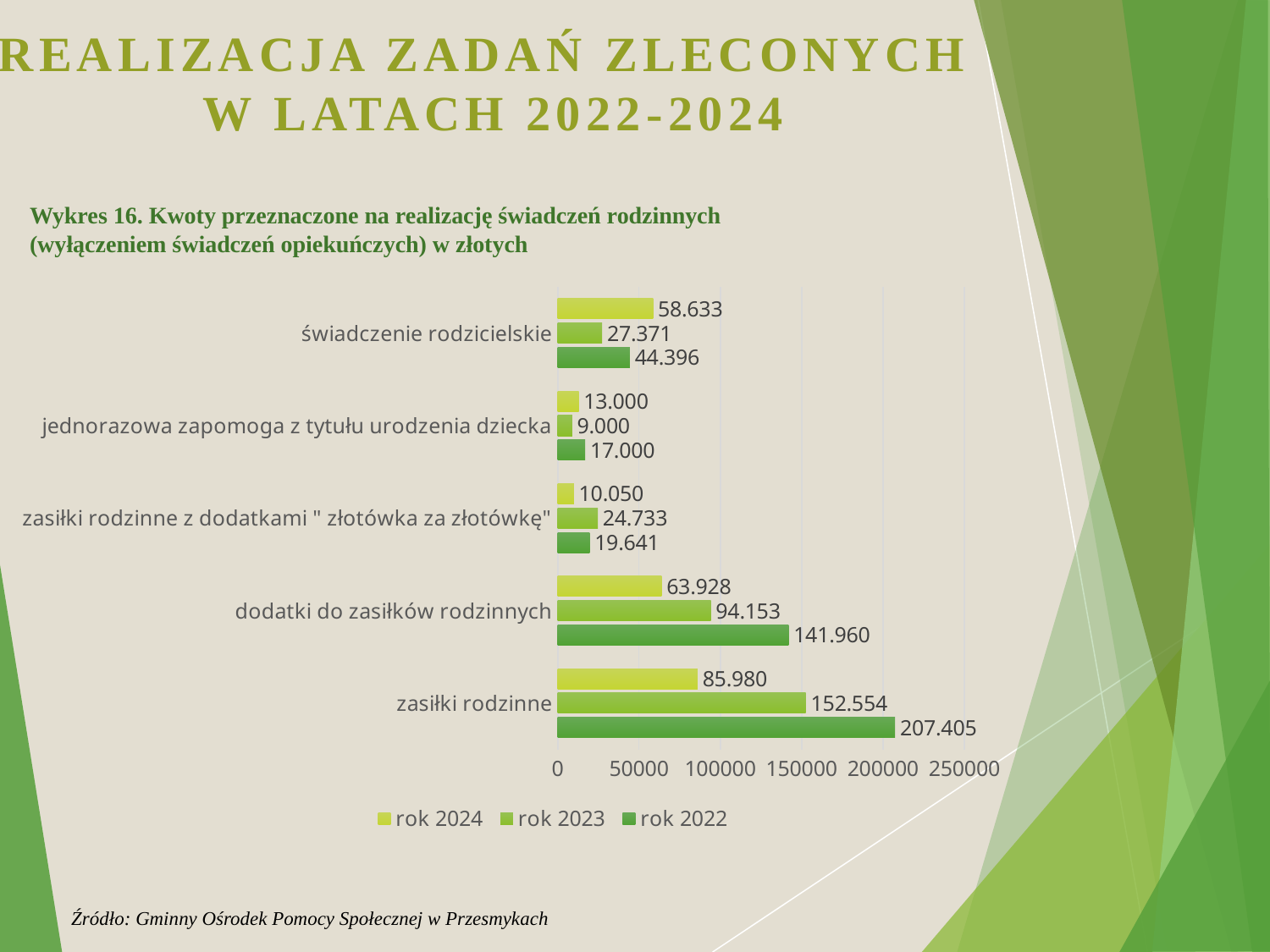
What is the value for świadczenie rodzicielskie in rok 2024? 58.633 What kind of chart is shown on the slide? bar chart Which category has the lowest value in rok 2024? zasiłki rodzinne z dodatkami " złotówka za złotówkę" Which is larger for zasiłki rodzinne z dodatkami " złotówka za złotówkę": the rok 2023 value or the rok 2022 value? rok 2023 What is the value for dodatki do zasiłków rodzinnych in rok 2023? 94.153 How many series does the legend list? 3 What is the value for jednorazowa zapomoga z tytułu urodzenia dziecka in rok 2023? 9.000 What is the difference between the rok 2022 and rok 2023 values for zasiłki rodzinne? 54.851 What is the difference between the rok 2022 and rok 2024 values for świadczenie rodzicielskie? 14.237 How many categories are shown on the chart? 5 Which category has the highest value in rok 2022? zasiłki rodzinne What is the value for zasiłki rodzinne in rok 2022? 207.405